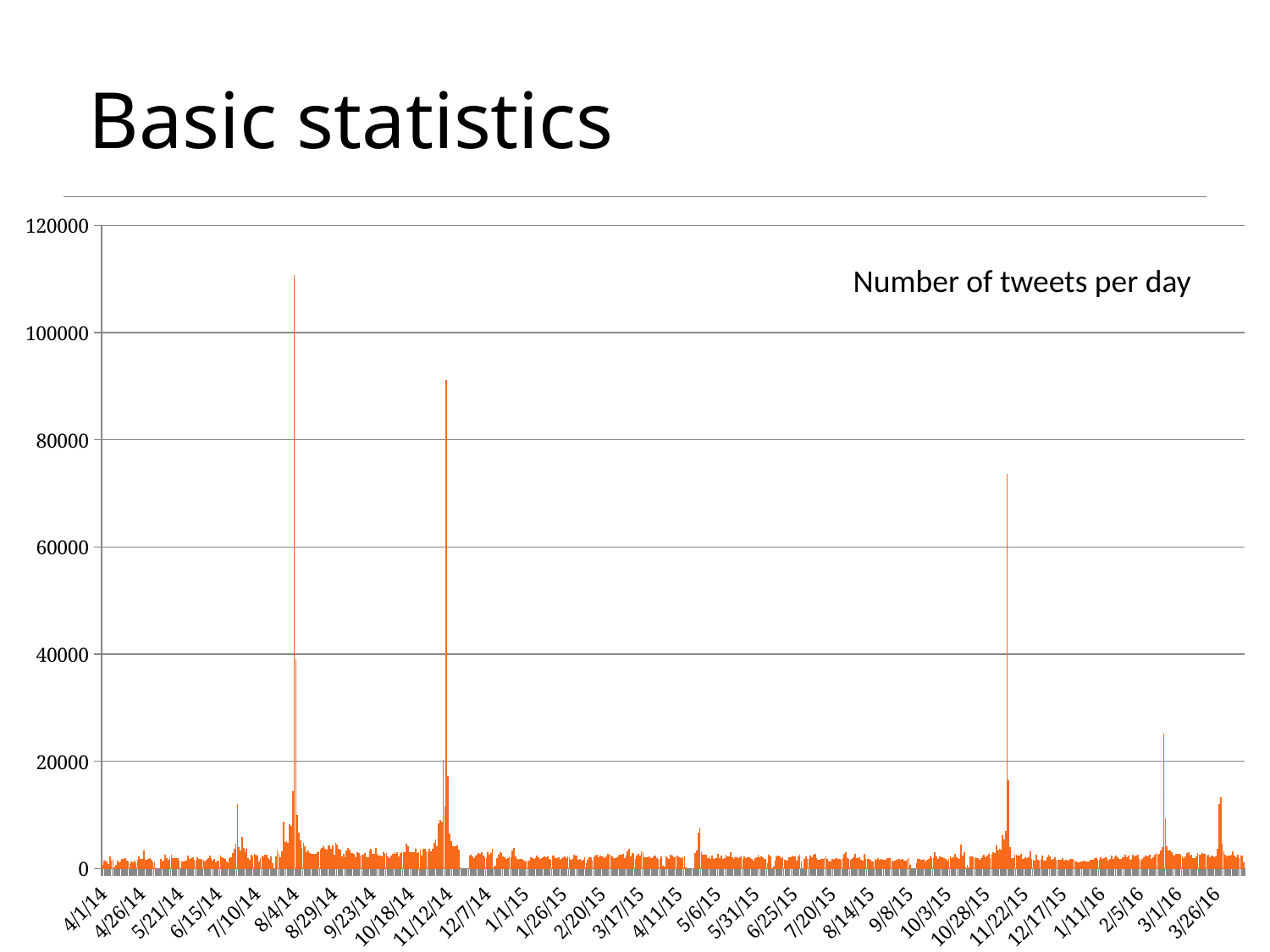
Is the spike near 11/12/14 greater or less than 100000? less What is the highest value shown on the vertical axis of the chart? 120000 What kind of chart is shown on the slide? bar chart Is the tallest spike in the chart, near 8/4/14, greater or less than 100000? greater Which spike is taller: the one near 8/4/14 or the one near 11/22/15? the one near 8/4/14 What does the chart say it plots, according to the text label inside the plot area? Number of tweets per day Which spike is taller: the one near 11/12/14 or the one near 3/1/16? the one near 11/12/14 Is the spike near 11/12/14 greater or less than 80000? greater